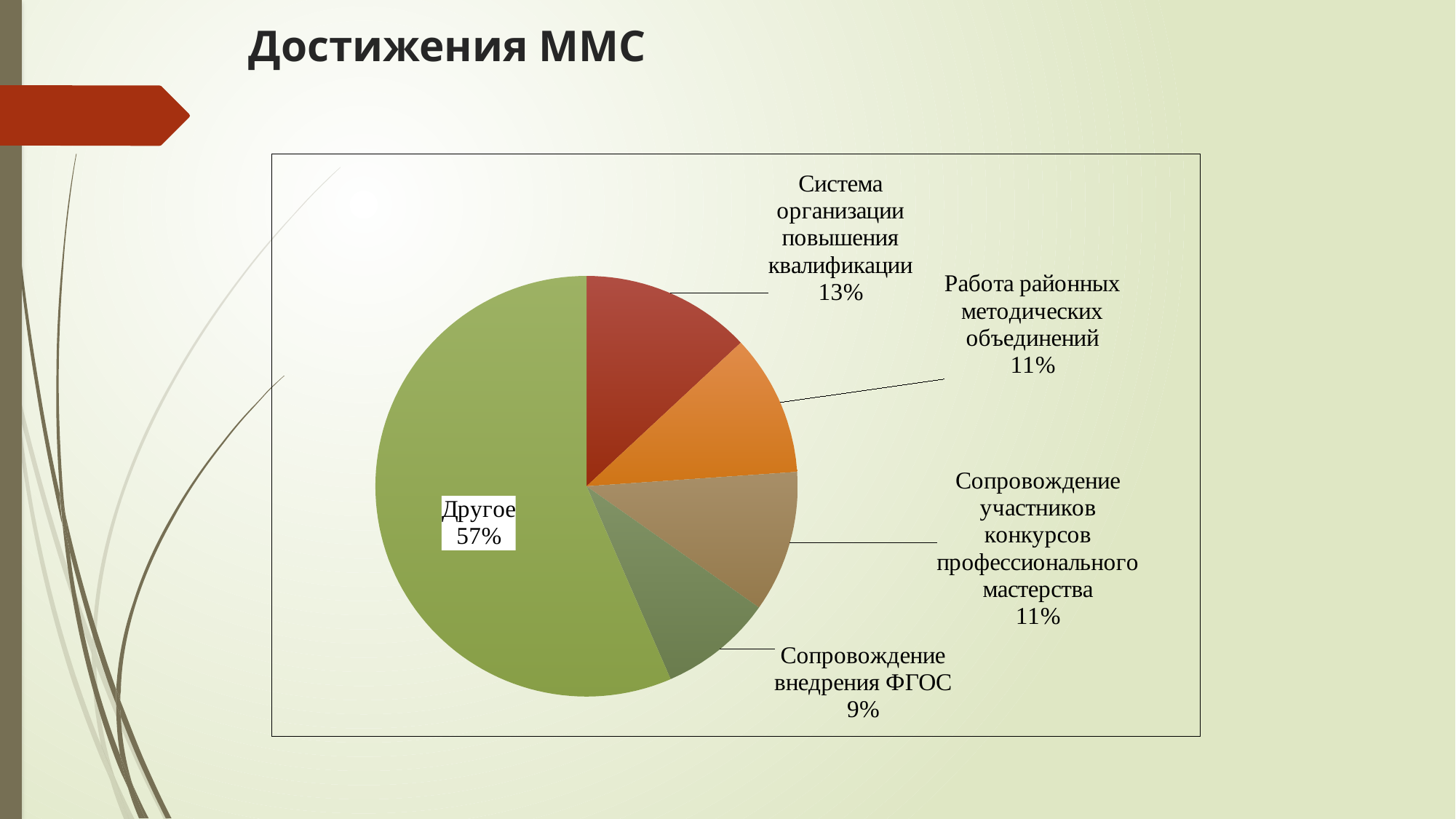
Which is larger: the share for "Система организации повышения квалификации" or the share for "Сопровождение внедрения ФГОС"? Система организации повышения квалификации What is the title of the slide containing the pie chart? Достижения ММС Which slice of the pie is the largest? Другое Which slice of the pie is the smallest? Сопровождение внедрения ФГОС What is the value shown for "Сопровождение внедрения ФГОС"? 9% What is the value shown for "Работа районных методических объединений"? 11% What share of the pie does "Другое" take? 57% How many slices does the pie chart have? 5 What is the difference between the shares of "Система организации повышения квалификации" and "Сопровождение внедрения ФГОС"? 4% What kind of chart is shown on the slide? pie chart What is the value shown for "Система организации повышения квалификации"? 13% What is the value shown for "Сопровождение участников конкурсов профессионального мастерства"? 11%